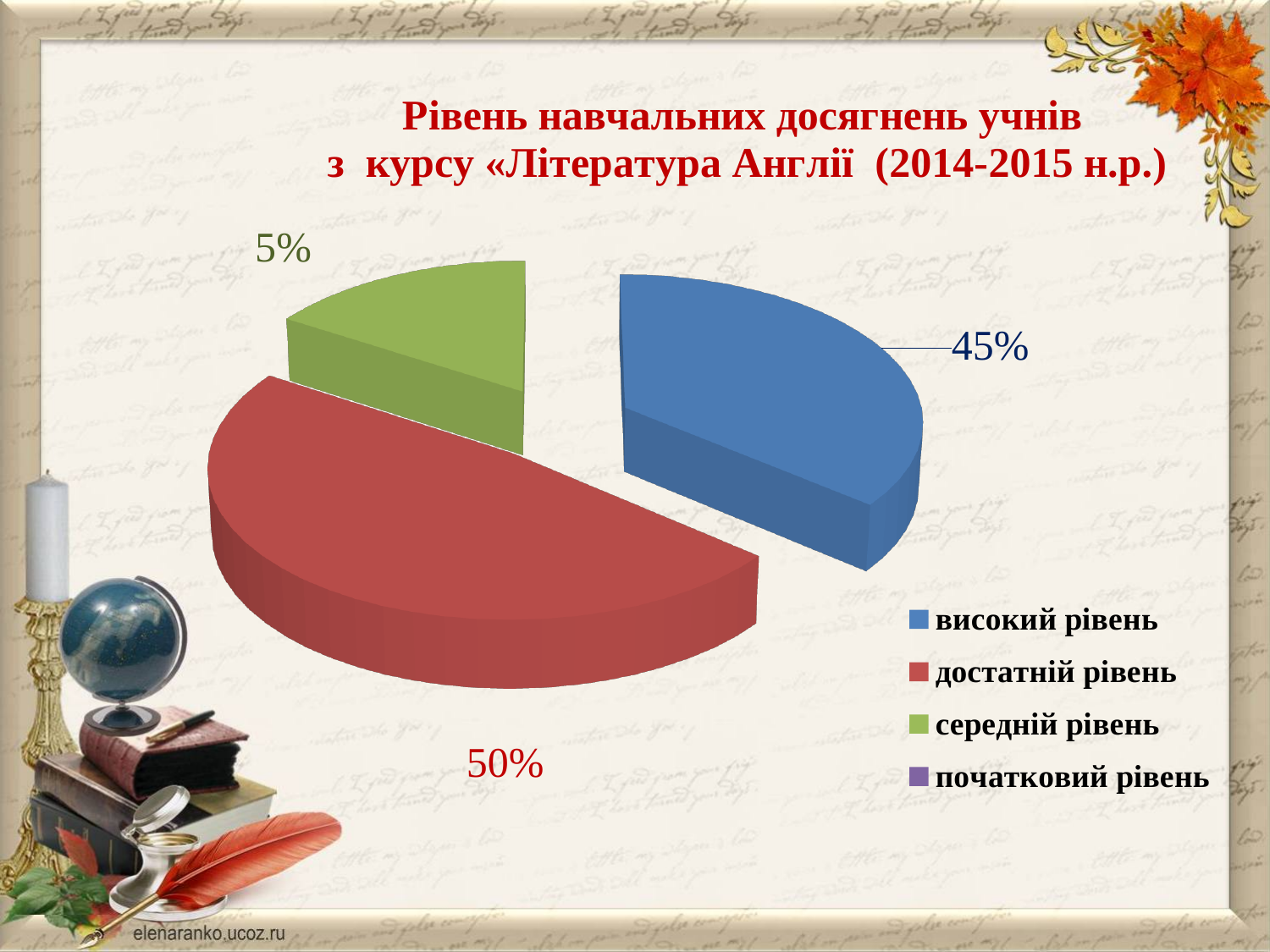
Which of the visible slices has the smallest share of the pie? середній рівень What share of the pie does «достатній рівень» have? 50% How many entries does the legend list? 4 What is the difference between the shares of «високий рівень» and «середній рівень»? 40% What share of the pie does «середній рівень» have? 5% Which level has the largest share of the pie? достатній рівень What kind of chart is shown on the slide? pie chart What is the difference between the shares of «достатній рівень» and «високий рівень»? 5% What colour is the slice for «достатній рівень»? red What share of the pie does «високий рівень» have? 45% Which is larger: the share of «високий рівень» or the share of «середній рівень»? високий рівень What is the title of the chart? Рівень навчальних досягнень учнів з курсу «Література Англії (2014-2015 н.р.)